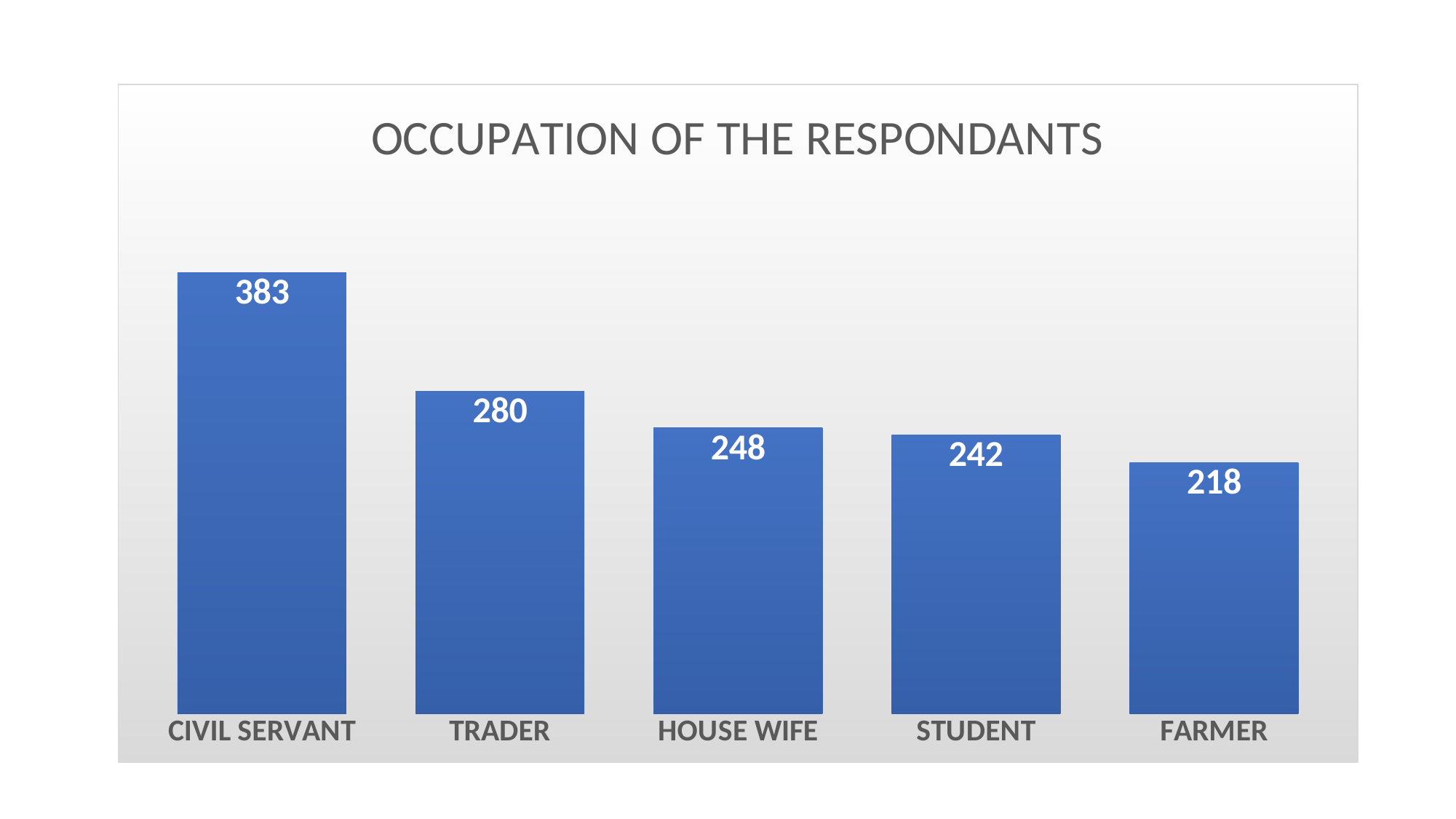
Which occupation has the highest number of respondents? CIVIL SERVANT What is the value for CIVIL SERVANT? 383 What is the difference between the values for CIVIL SERVANT and TRADER? 103 Which is larger, the value for TRADER or the value for STUDENT? TRADER What is the value for HOUSE WIFE? 248 Which occupation has the lowest number of respondents? FARMER How many occupation categories are shown in the chart? 5 What is the difference between the values for STUDENT and FARMER? 24 What is the value for FARMER? 218 What kind of chart is shown on the slide? Bar chart What is the title of the chart? OCCUPATION OF THE RESPONDANTS What is the value for TRADER? 280